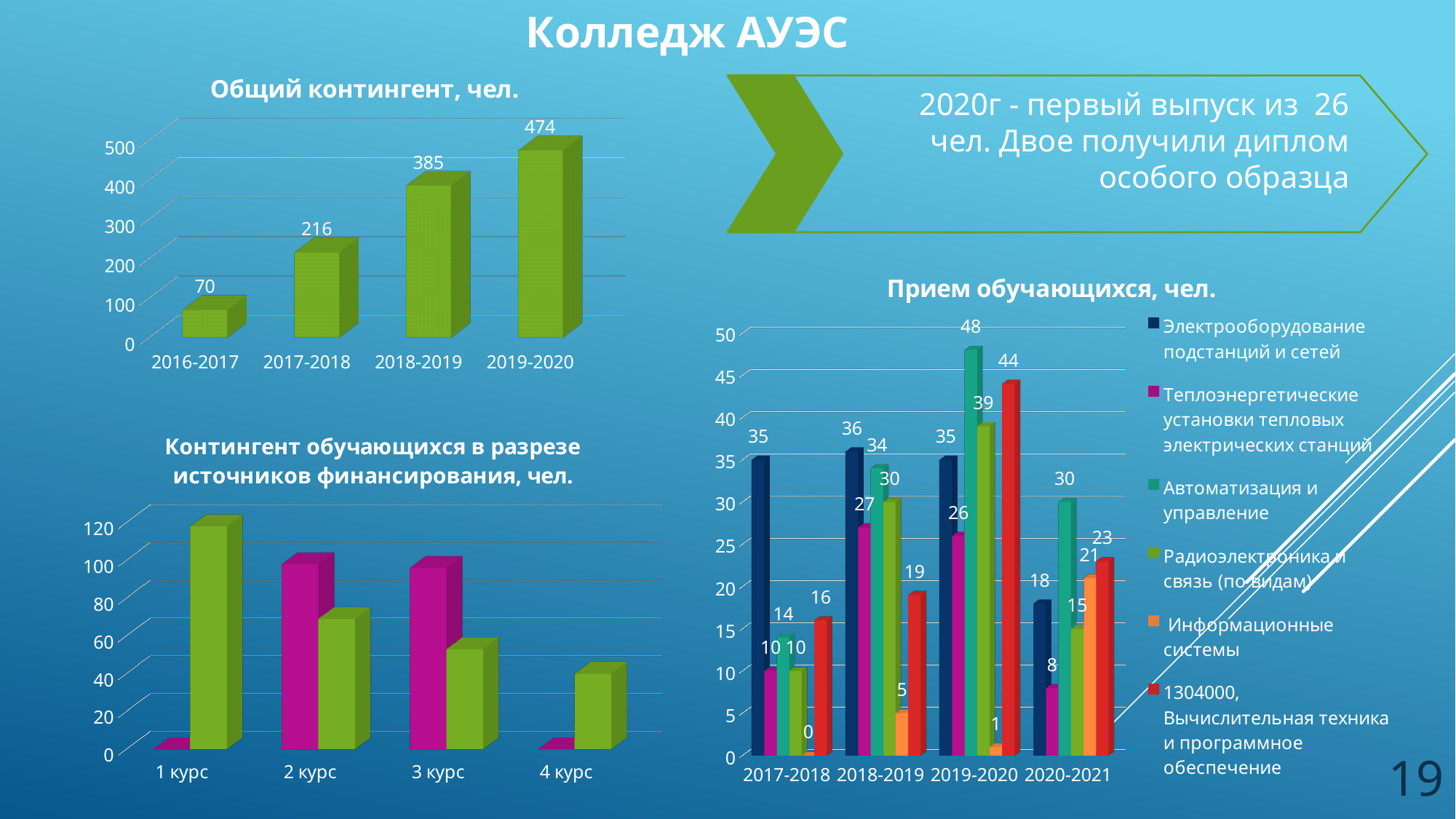
In the chart 'Общий контингент, чел.', how many years are shown on the x axis? 4 In the chart 'Прием обучающихся, чел.', how many series does the legend list? 6 In the chart 'Общий контингент, чел.', do the values rise or fall from 2016-2017 to 2019-2020? rise In the chart 'Общий контингент, чел.', which year has the lowest value? 2016-2017 In the chart 'Прием обучающихся, чел.', what is the difference between Электрооборудование подстанций и сетей in 2018-2019 and in 2020-2021? 18 In the chart 'Контингент обучающихся в разрезе источников финансирования, чел.', is the green bar for 1 курс greater or less than 100? greater In the chart 'Прием обучающихся, чел.', what is the value for Автоматизация и управление in 2019-2020? 48 In the chart 'Общий контингент, чел.', what is the value for 2019-2020? 474 In the chart 'Контингент обучающихся в разрезе источников финансирования, чел.', is the green bar for 4 курс greater or less than 60? less In the chart 'Прием обучающихся, чел.', which is larger in 2020-2021: Информационные системы or Радиоэлектроника и связь (по видам)? Информационные системы In the chart 'Контингент обучающихся в разрезе источников финансирования, чел.', what kind of chart is it? bar chart In the chart 'Общий контингент, чел.', what is the difference between the values for 2018-2019 and 2017-2018? 169